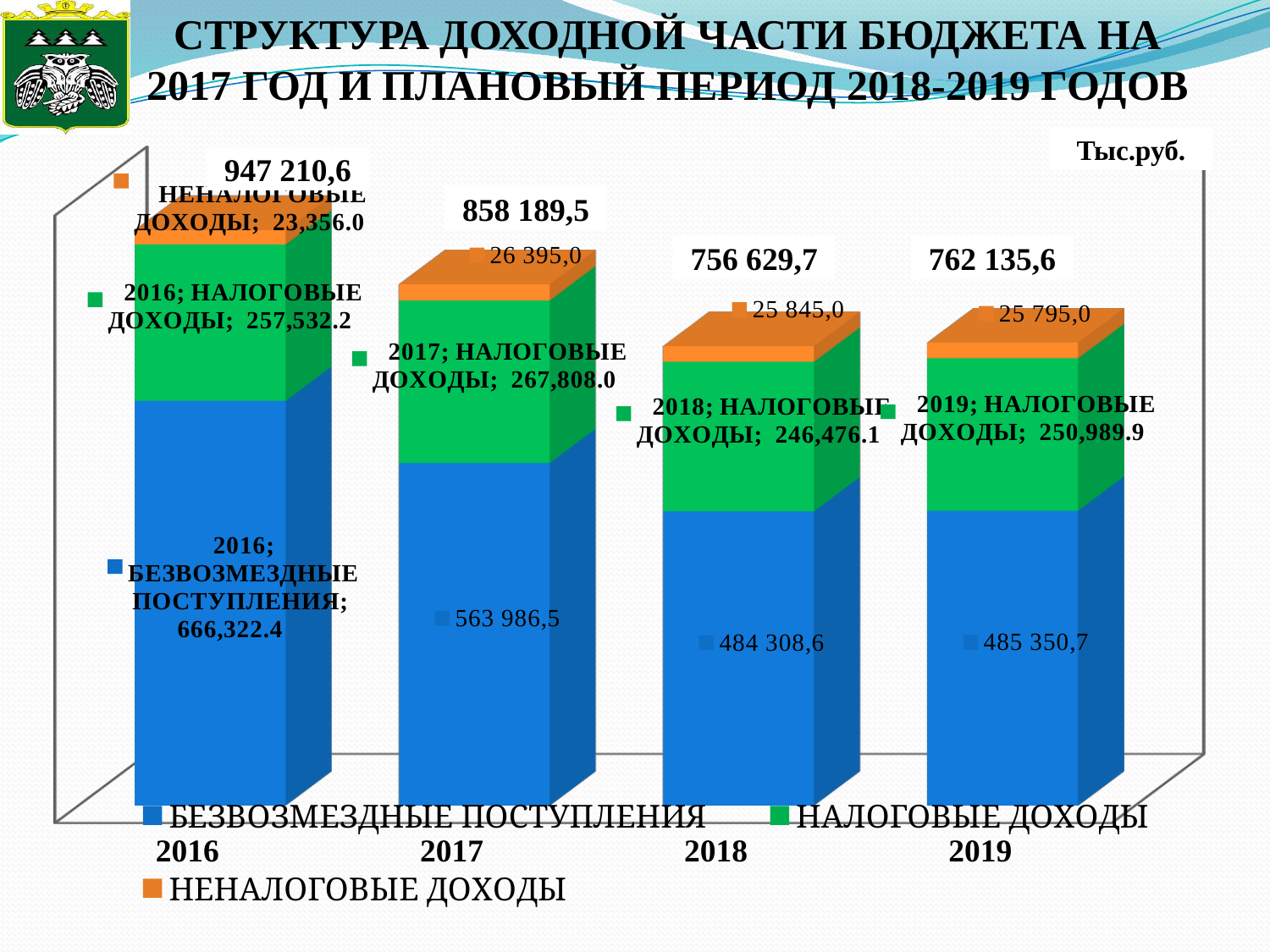
What is the value of БЕЗВОЗМЕЗДНЫЕ ПОСТУПЛЕНИЯ for 2017? 563 986,5 What is the total shown above the stacked bar for 2017? 858 189,5 How many series does the legend list? 3 What is the difference between the totals for 2016 and 2017? 89 021,1 What is the value of НАЛОГОВЫЕ ДОХОДЫ for 2019? 250,989.9 What is the value of НЕНАЛОГОВЫЕ ДОХОДЫ for 2018? 25 845,0 How many years are shown on the x axis? 4 What kind of chart is shown on the slide? Stacked bar chart Which is larger: НАЛОГОВЫЕ ДОХОДЫ for 2017 or for 2016? 2017 Which year has the lowest total shown above its bar? 2018 Which year has the highest total shown above its bar? 2016 Do the БЕЗВОЗМЕЗДНЫЕ ПОСТУПЛЕНИЯ values rise or fall from 2016 to 2018? Fall